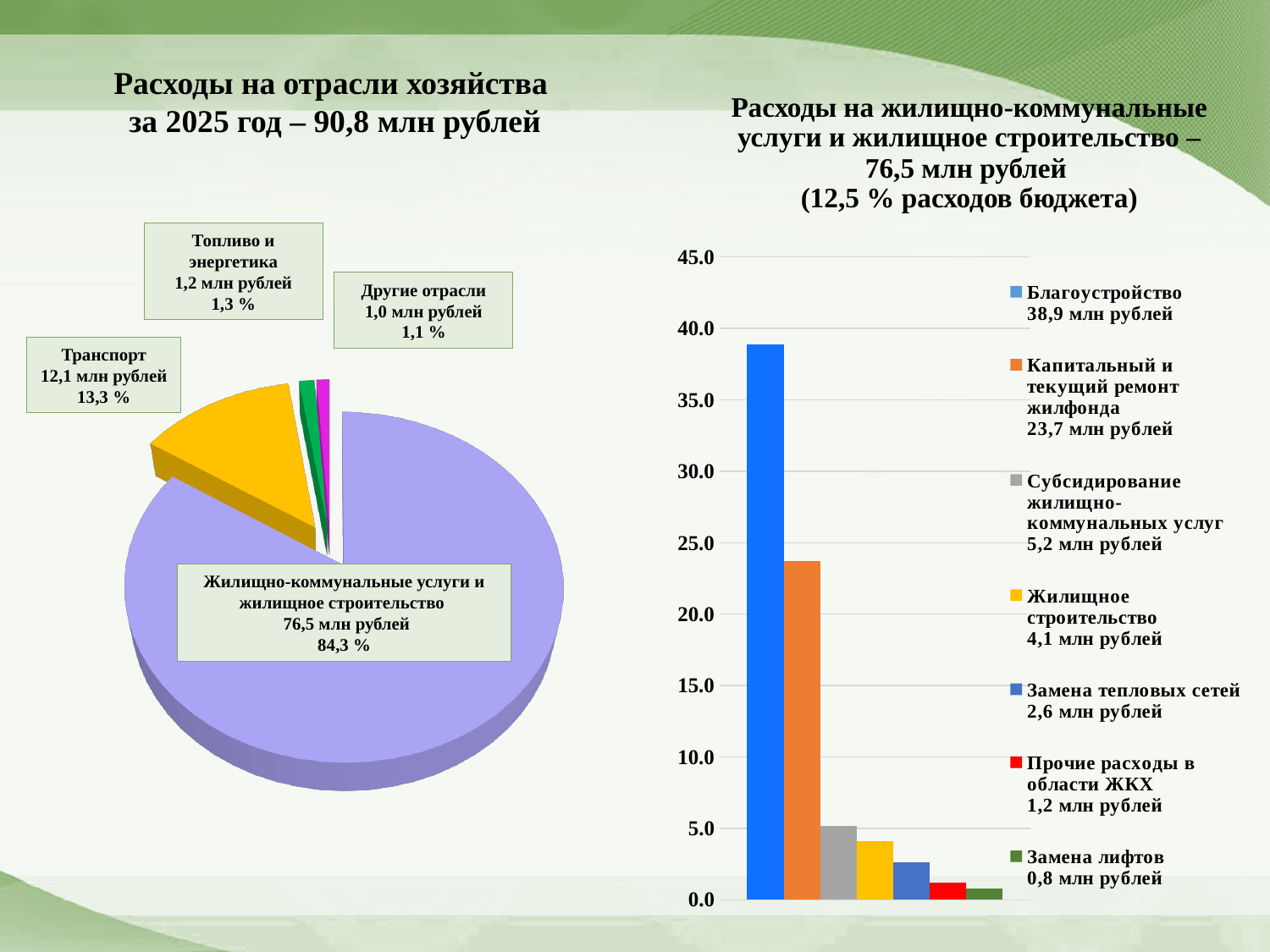
What kind of chart is shown on the right side of the slide? Bar chart What kind of chart is shown on the left side of the slide? Pie chart On the left pie chart, what share of the pie does 'Жилищно-коммунальные услуги и жилищное строительство' take? 84,3 % On the left pie chart, what is the difference in млн рублей between Транспорт and Топливо и энергетика? 10,9 млн рублей On the right bar chart, what is the difference between Благоустройство and Капитальный и текущий ремонт жилфонда? 15,2 млн рублей On the left pie chart 'Расходы на отрасли хозяйства за 2025 год', what is the value for Транспорт? 12,1 млн рублей On the left pie chart, which category has the smallest slice? Другие отрасли On the right bar chart, which category has the lowest value? Замена лифтов On the left pie chart, how many slices are there? 4 On the right bar chart, which is larger: Субсидирование жилищно-коммунальных услуг or Жилищное строительство? Субсидирование жилищно-коммунальных услуг On the right bar chart 'Расходы на жилищно-коммунальные услуги и жилищное строительство', what is the value for Благоустройство? 38,9 млн рублей On the right bar chart, how many series does the legend list? 7